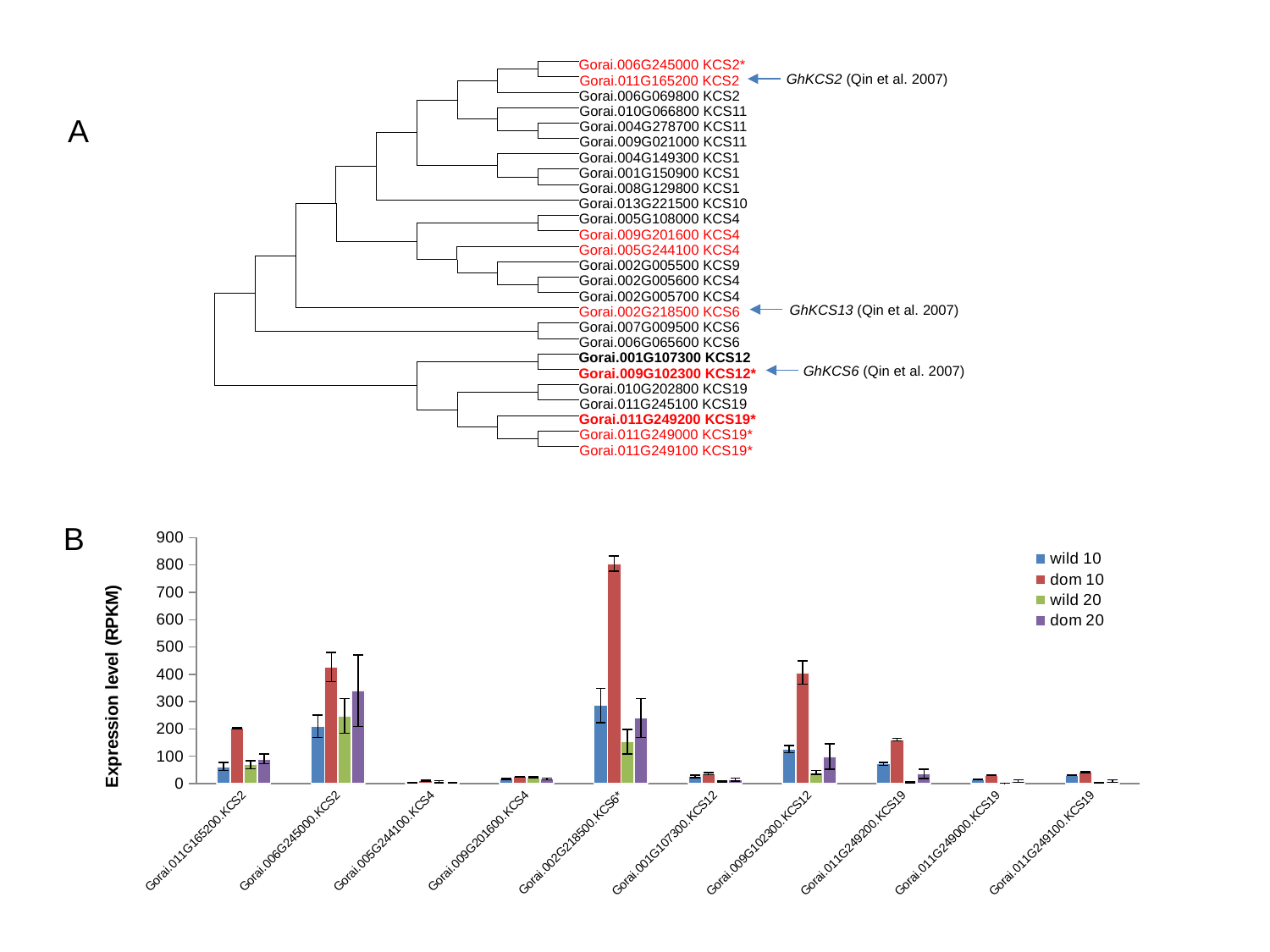
In the bar chart in panel B, which series is shown in red according to the legend? dom 10 What kind of chart is shown in panel B? bar chart In the bar chart in panel B, is the dom 10 value for Gorai.009G102300.KCS12 greater or less than 300? greater In the bar chart in panel B, how many series does the legend list? 4 In the bar chart in panel B, how many gene categories are shown on the x axis? 10 In the bar chart in panel B, which gene has the highest dom 10 expression level? Gorai.002G218500.KCS6* In the bar chart in panel B, is the wild 10 value for Gorai.002G218500.KCS6* greater or less than 200? greater In the bar chart in panel B, is the dom 10 value for Gorai.002G218500.KCS6* greater or less than 700? greater What is the y-axis title of the bar chart in panel B? Expression level (RPKM) In the bar chart in panel B, which is larger for Gorai.009G102300.KCS12: the wild 10 value or the dom 10 value? dom 10 In the bar chart in panel B, which gene has the larger dom 10 value: Gorai.002G218500.KCS6* or Gorai.006G245000.KCS2? Gorai.002G218500.KCS6*